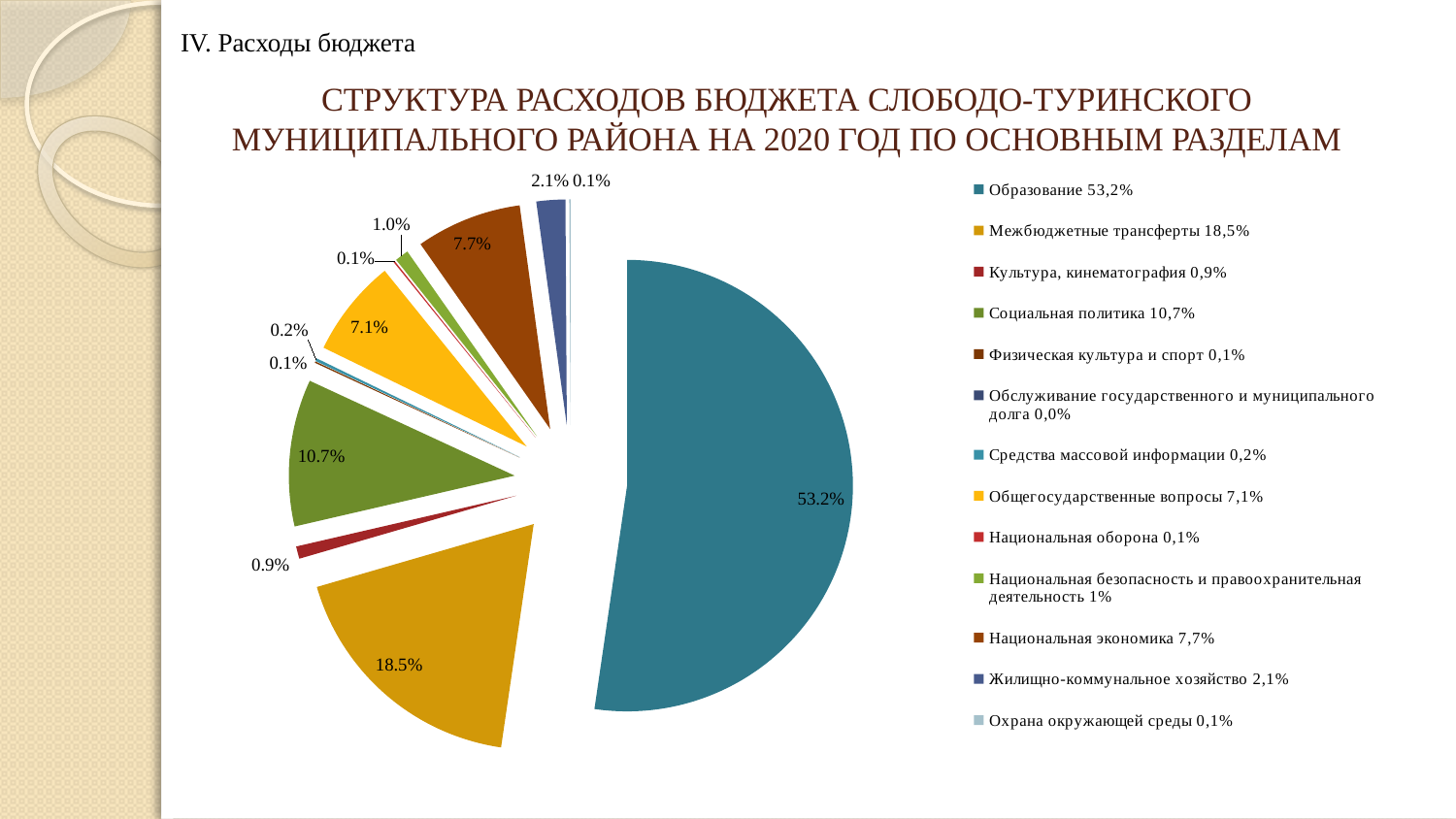
What is the value for Жилищно-коммунальное хозяйство? 2.1% What is the difference between the shares of Образование and Межбюджетные трансферты? 34.7% Which is larger: the share for Социальная политика or for Общегосударственные вопросы? Социальная политика What is the value for Межбюджетные трансферты? 18.5% What kind of chart is shown on the slide? Pie chart What is the value for Социальная политика? 10.7% Which category has the largest share of the budget expenditure? Образование How many categories does the legend list? 13 What share of the budget expenditure goes to Образование? 53.2% What is the value for Национальная экономика? 7.7% Which category has the smallest share according to the legend? Обслуживание государственного и муниципального долга What year does the chart title say the budget expenditure structure refers to? 2020